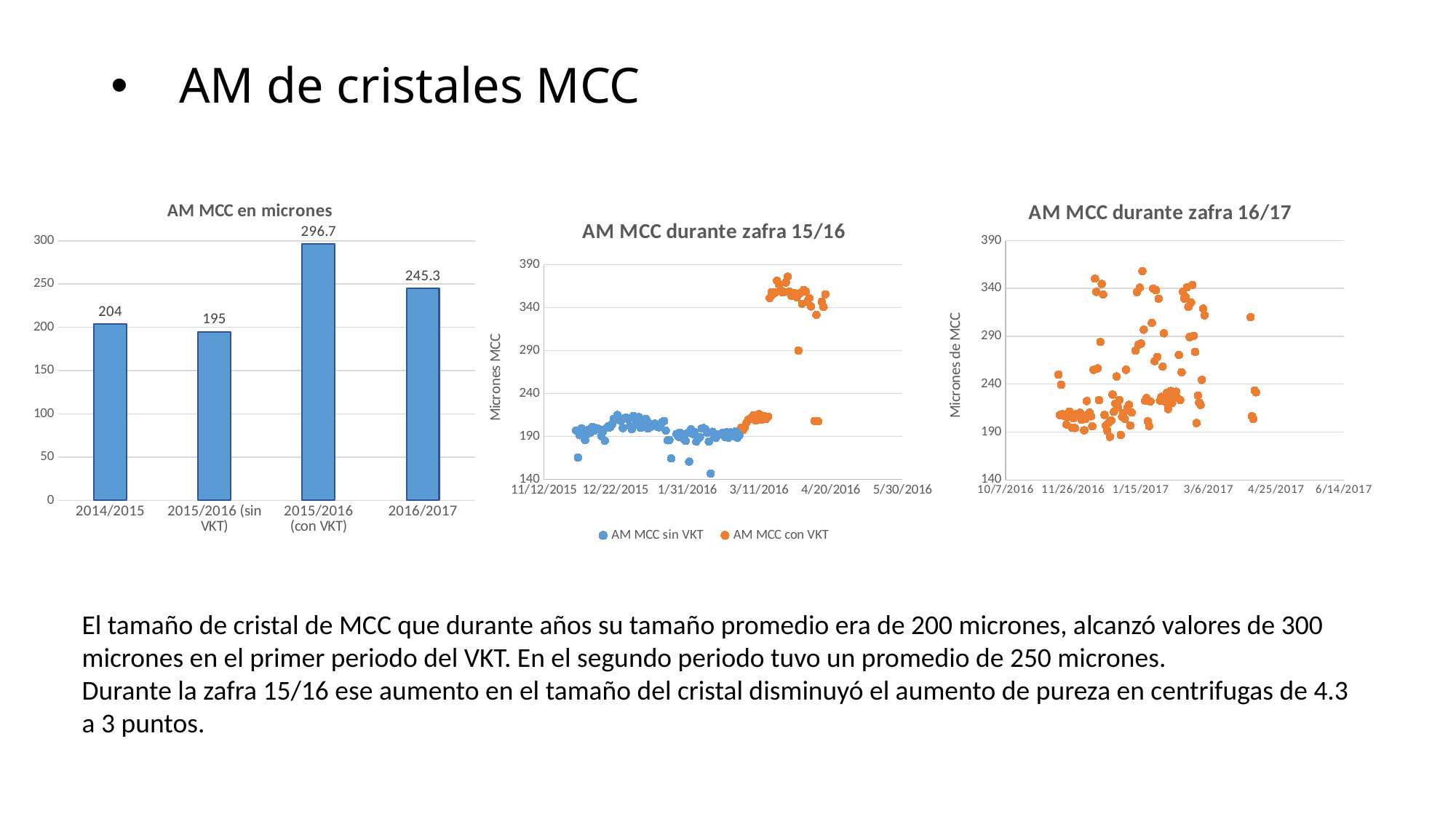
In the 'AM MCC en micrones' chart, which category has the lowest value? 2015/2016 (sin VKT) In the 'AM MCC en micrones' chart, what is the difference between the 2015/2016 (con VKT) value and the 2016/2017 value? 51.4 In the 'AM MCC en micrones' chart, which is larger: the value for 2014/2015 or the value for 2015/2016 (sin VKT)? 2014/2015 What kind of chart is 'AM MCC durante zafra 15/16'? Scatter chart In the 'AM MCC en micrones' chart, which category has the highest value? 2015/2016 (con VKT) How many bars are in the 'AM MCC en micrones' chart? 4 In the 'AM MCC en micrones' chart, what is the value for 2015/2016 (con VKT)? 296.7 How many series does the legend of the 'AM MCC durante zafra 15/16' chart list? 2 In the 'AM MCC en micrones' chart, what is the value for 2014/2015? 204 What is the y-axis title of the 'AM MCC durante zafra 16/17' chart? Micrones de MCC In the 'AM MCC en micrones' chart, what is the value for 2016/2017? 245.3 What kind of chart is 'AM MCC en micrones'? Bar chart